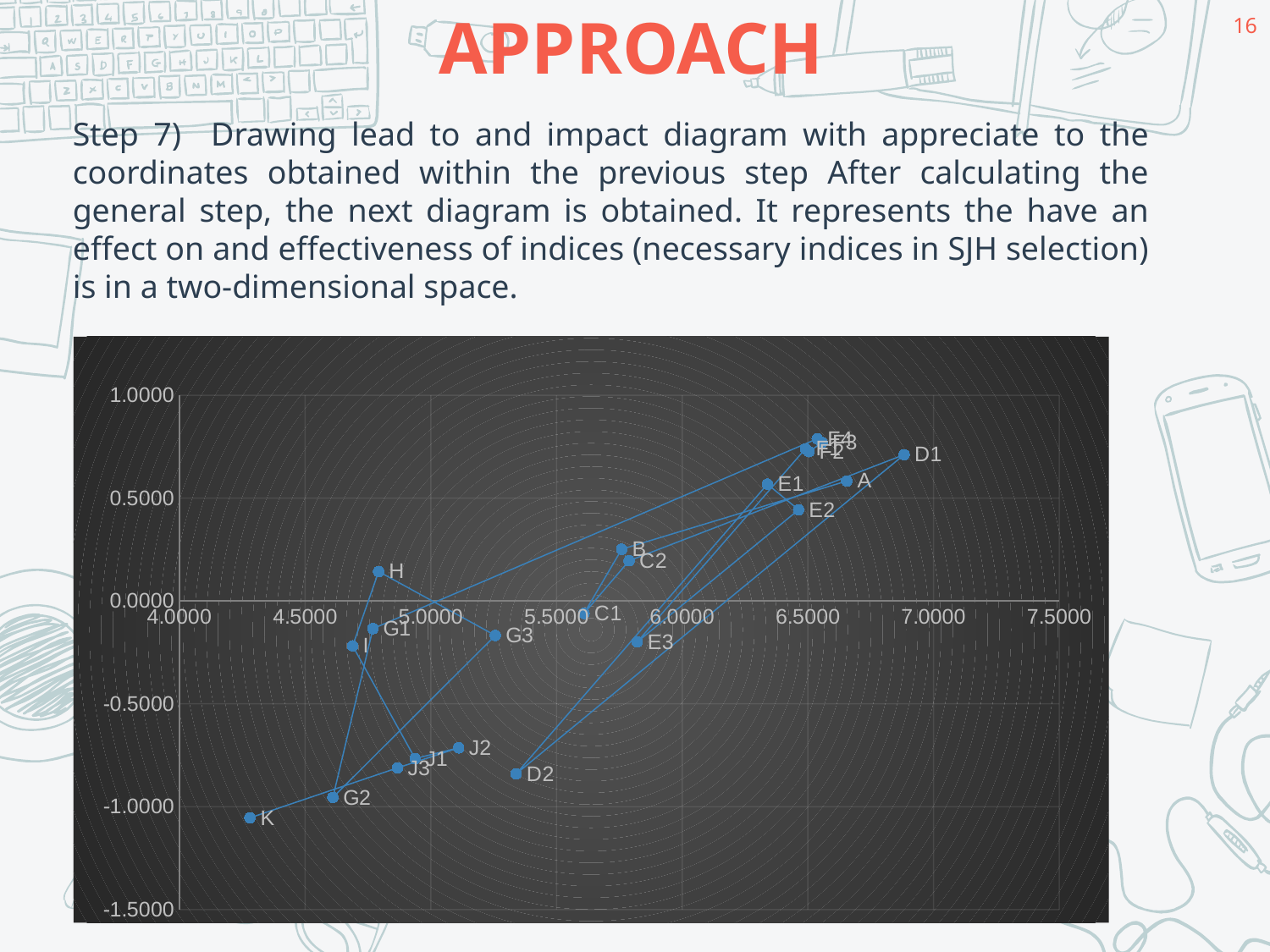
What is the highest value shown on the x axis? 7.5000 Which point has the larger y-axis value, H or I? H Is the y-axis value for G3 greater or less than 0.0000? less Which labeled point has the smallest x-axis value? K What kind of chart is shown on the slide? scatter chart Is the x-axis value for K greater or less than 4.5000? less Which labeled point has the lowest y-axis value? K Is the x-axis value for D1 greater or less than 6.5000? greater Which point has the larger x-axis value, D1 or A? D1 Which labeled point has the largest x-axis value? D1